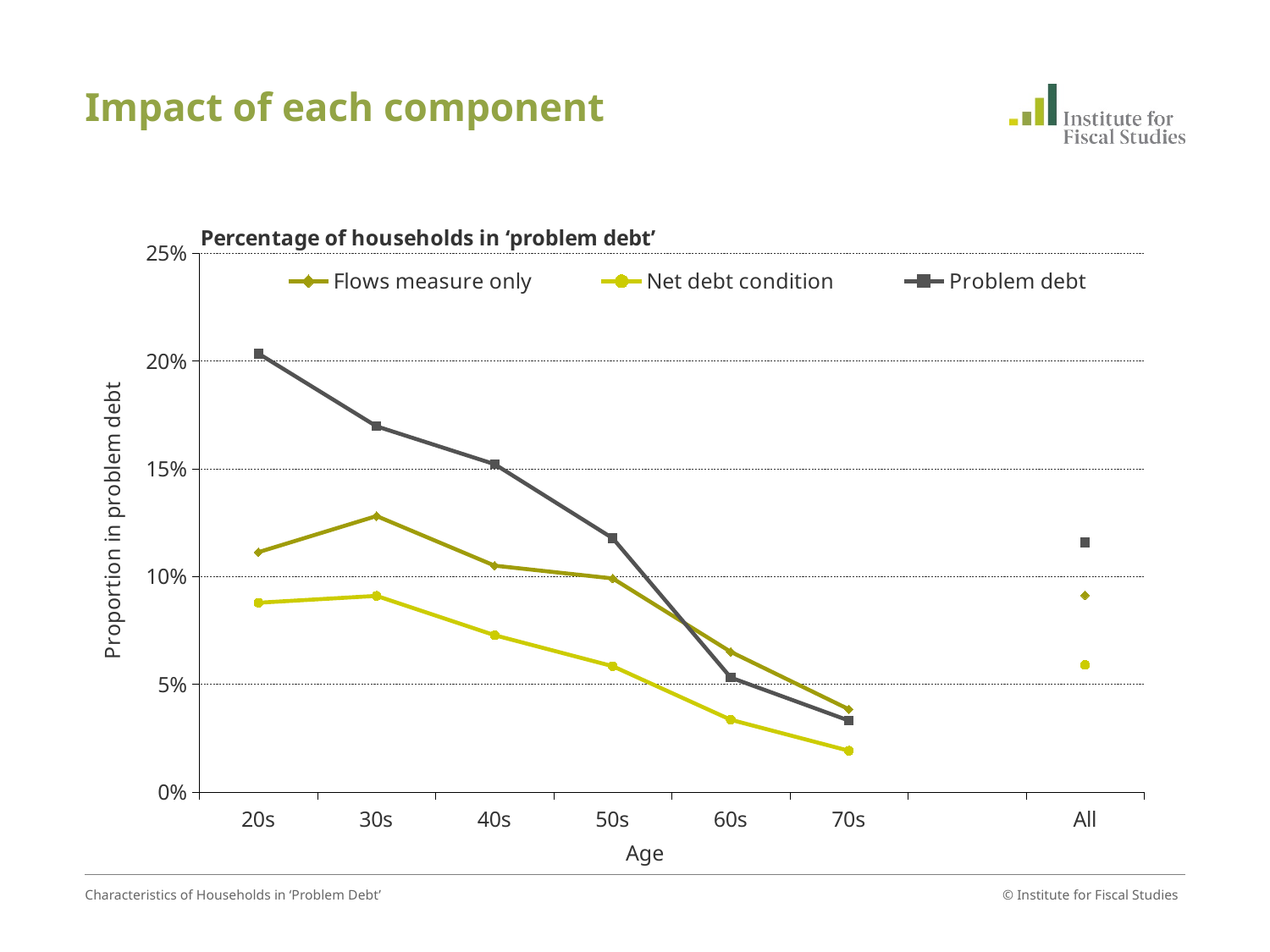
Does the Problem debt series rise or fall from the 20s to the 70s? Fall How many series does the legend list? 3 Is the value for Flows measure only in the 30s greater or less than 10%? greater Is the value for Net debt condition in the 20s greater or less than 10%? less In the 60s age group, which is larger: Flows measure only or Problem debt? Flows measure only For which age group is the Problem debt series highest? 20s What kind of chart is shown on the slide? Line chart Is the value for Problem debt in the 30s greater or less than 15%? greater What is the title of the chart? Percentage of households in ‘problem debt’ For which age group is the Net debt condition series lowest? 70s How many categories are shown on the x axis? 7